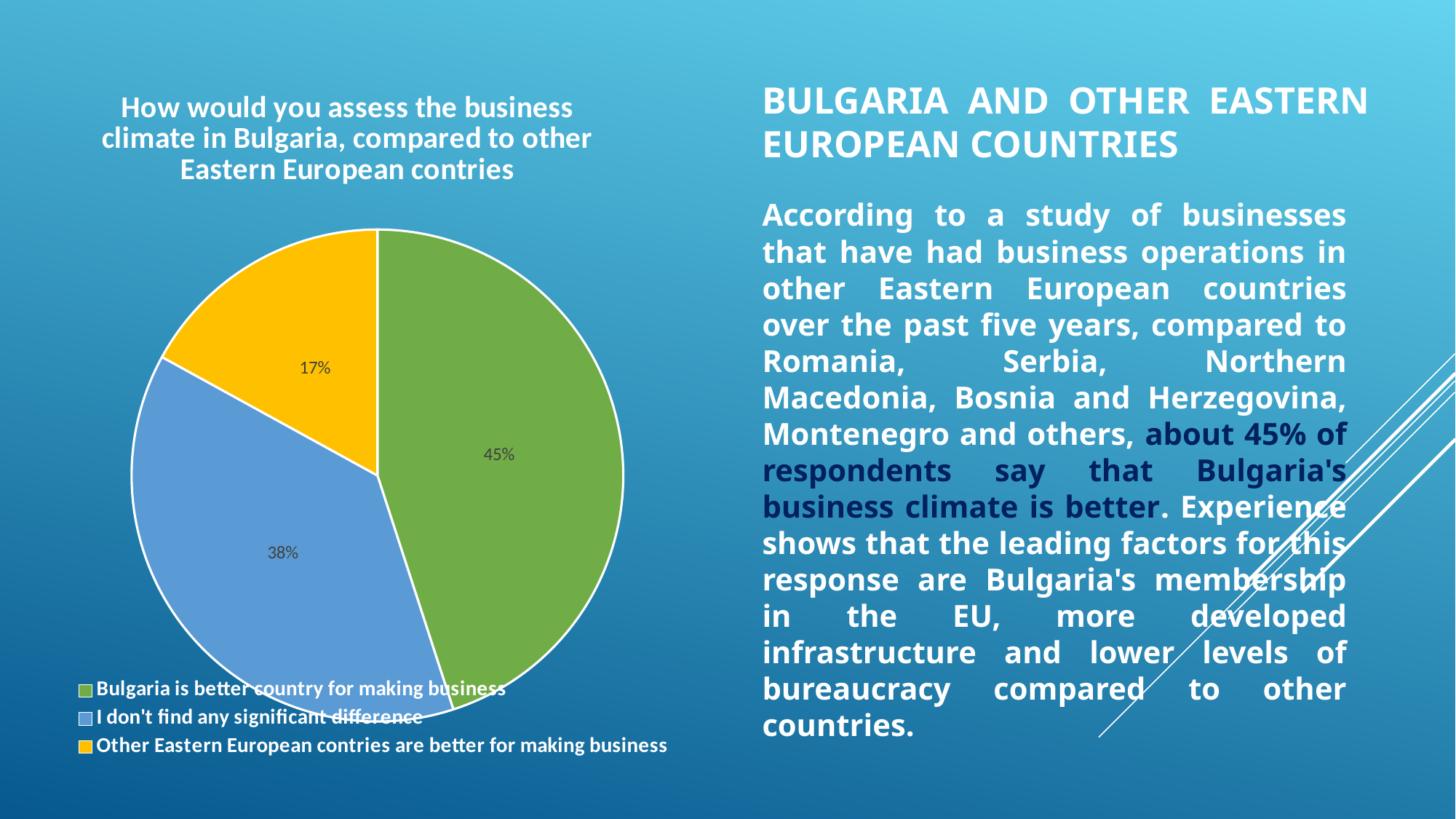
What is the difference in percentage points between 'Bulgaria is better country for making business' and 'I don't find any significant difference'? 7 percentage points Which response has the largest share of the pie? Bulgaria is better country for making business What share of respondents said Bulgaria is better country for making business? 45% How many slices does the pie chart have? 3 What kind of chart is shown on the slide? pie chart What is the difference in percentage points between 'I don't find any significant difference' and 'Other Eastern European contries are better for making business'? 21 percentage points What share of respondents said they don't find any significant difference? 38% What colour is the slice for 'Bulgaria is better country for making business'? green Which is larger: the share for 'I don't find any significant difference' or the share for 'Other Eastern European contries are better for making business'? I don't find any significant difference Which response has the smallest share of the pie? Other Eastern European contries are better for making business What share of respondents said other Eastern European countries are better for making business? 17% What is the title of the pie chart? How would you assess the business climate in Bulgaria, compared to other Eastern European contries